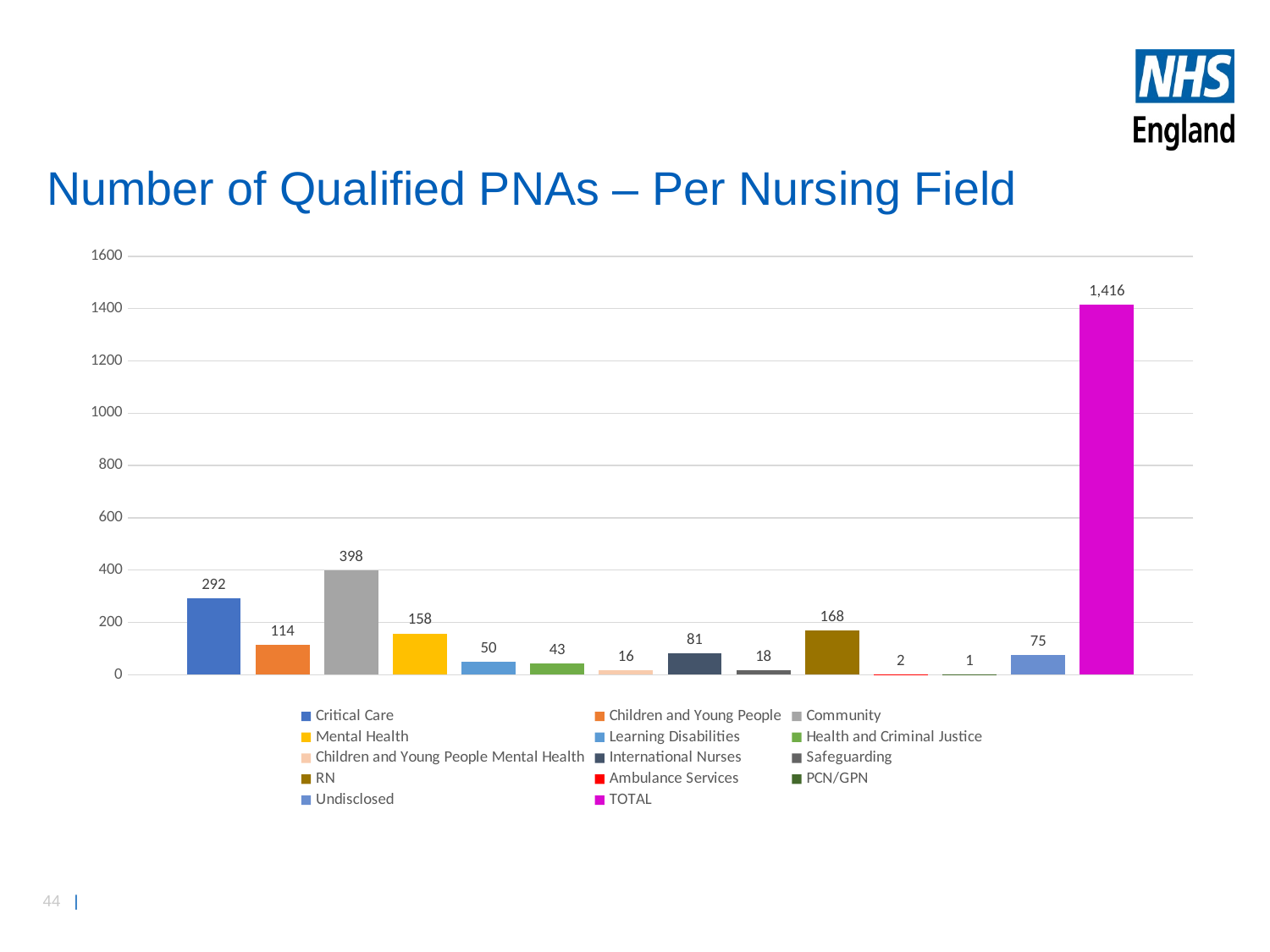
What is the value shown for TOTAL? 1,416 How many bars are plotted in the chart? 14 What is the value for Critical Care? 292 Which category has the lowest value? PCN/GPN What is the difference between the values for Community and Critical Care? 106 How many entries does the legend list? 14 Which is larger, the value for RN or the value for Mental Health? RN What is the value for International Nurses? 81 Is the value for TOTAL greater or less than 1400? greater What kind of chart is shown on the slide? Bar chart What is the value for Community? 398 Excluding the TOTAL bar, which nursing field has the highest number of qualified PNAs? Community